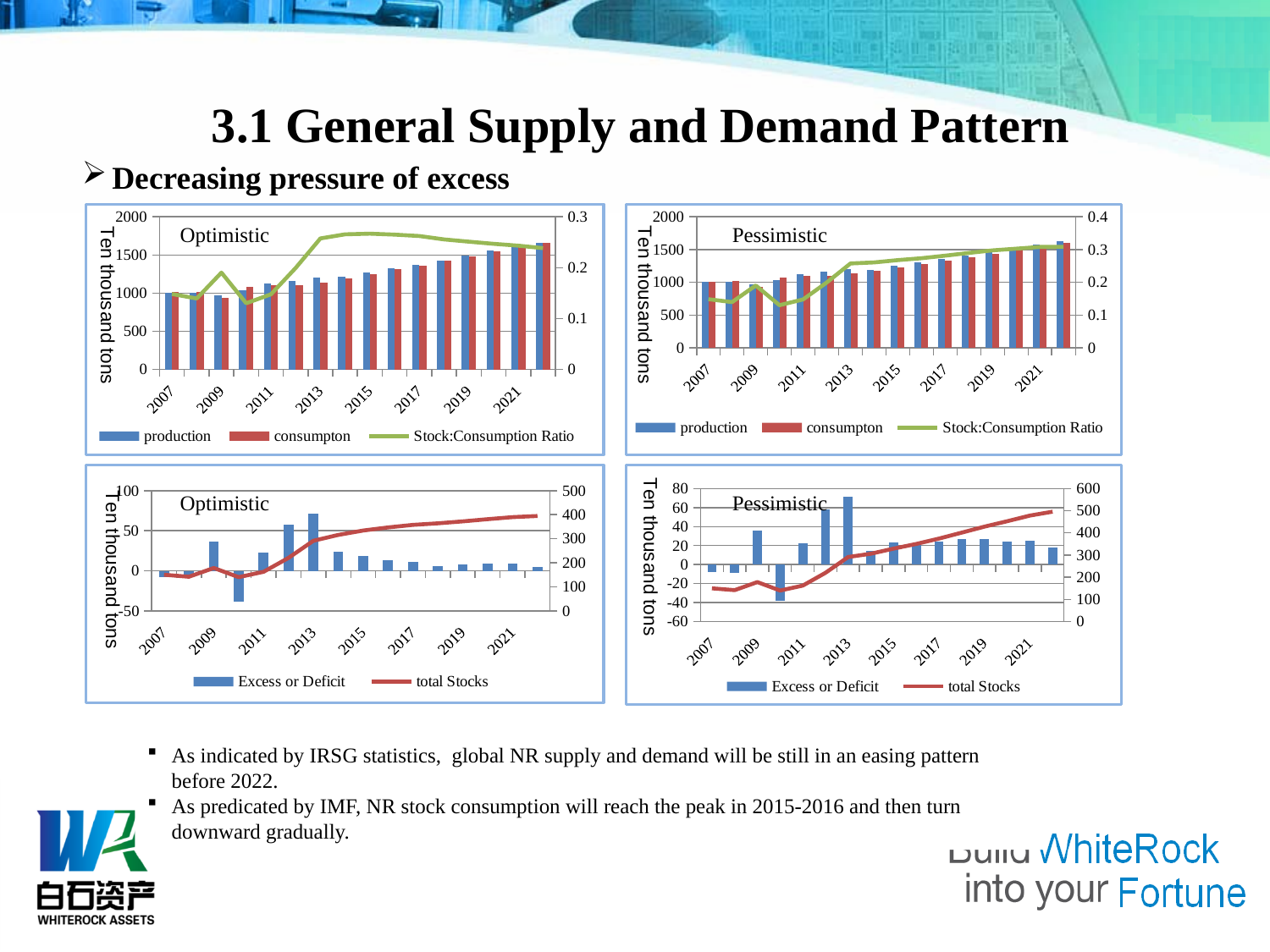
In the bottom-left Optimistic chart, which year has the lowest Excess or Deficit bar? 2010 In the bottom-right Pessimistic chart, does the total Stocks line rise or fall from 2011 to 2022? rise In the bottom-right Pessimistic chart, which year has the highest Excess or Deficit bar? 2013 In the top-left Optimistic chart, does production rise or fall from 2007 to 2022? rise In the bottom-right Pessimistic chart, is the Excess or Deficit value for 2010 greater or less than -20? less In the bottom-left Optimistic chart, is the Excess or Deficit value for 2013 greater or less than 50? greater What is the y-axis label on the top-left Optimistic chart? Ten thousand tons In the bottom-left Optimistic chart, which year has the highest Excess or Deficit bar? 2013 In the top-left Optimistic chart, how many series does the legend list? 3 In the top-left Optimistic chart, is the production value for 2007 greater or less than 500? greater What kind of chart is the top-right Pessimistic chart? Combined bar and line chart In the bottom-right Pessimistic chart, how many series does the legend list? 2